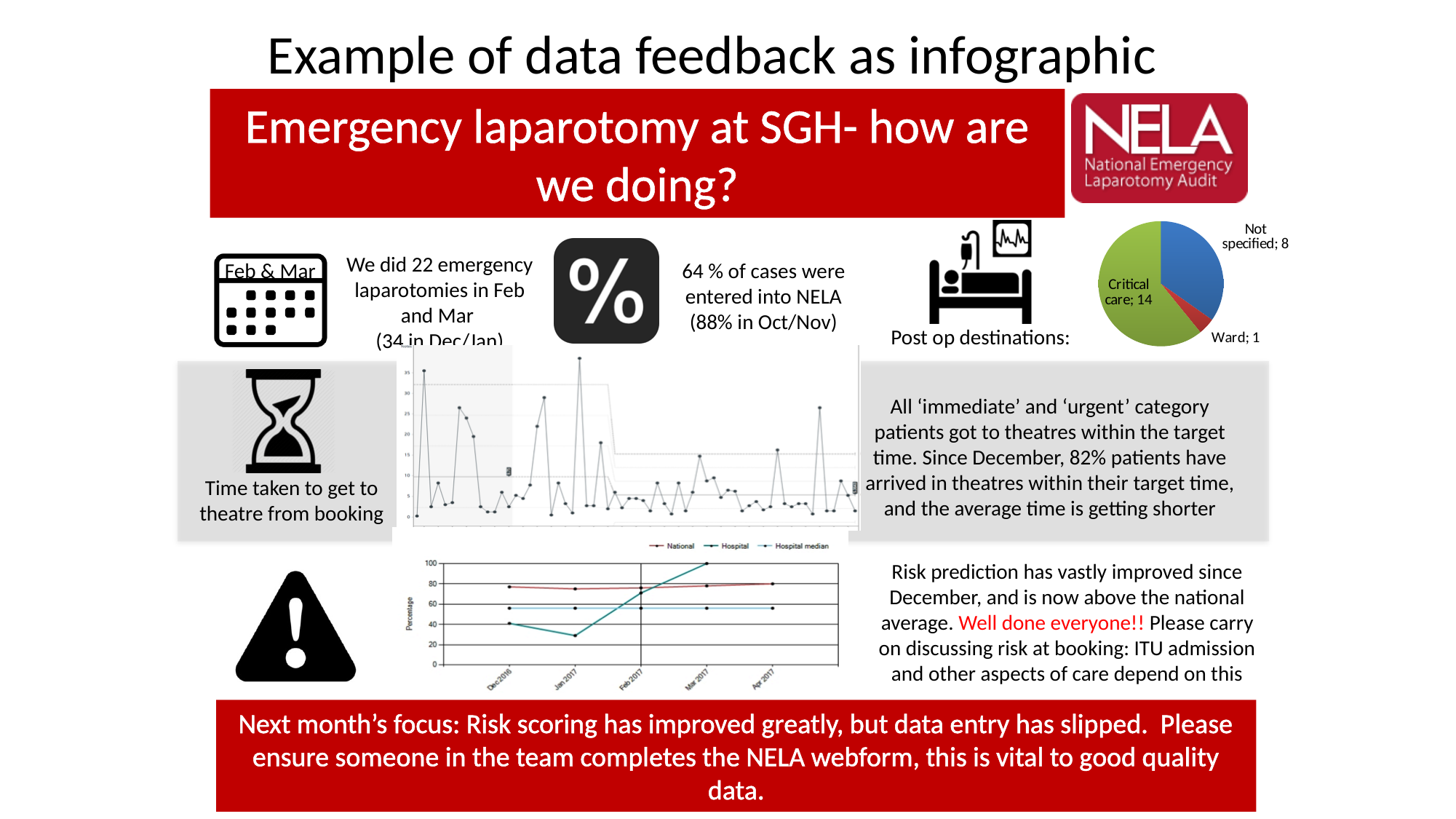
In the risk prediction line chart at the bottom of the slide, how many series does the legend list? 3 In the 'Post op destinations' pie chart, which destination has the smallest slice? Ward In the risk prediction line chart at the bottom of the slide, is the Hospital value for Jan 2017 greater or less than 40? less In the 'Post op destinations' pie chart, what is the value for Not specified? 8 In the 'Post op destinations' pie chart, what is the value for Ward? 1 In the risk prediction line chart at the bottom of the slide, how many months are shown on the x axis? 5 In the risk prediction line chart at the bottom of the slide, which is higher in Mar 2017, the Hospital value or the National value? Hospital In the 'Post op destinations' pie chart, what is the difference between the Critical care and Not specified values? 6 How many slices does the 'Post op destinations' pie chart have? 3 In the 'Post op destinations' pie chart, which destination has the largest slice? Critical care What kind of chart is the 'Post op destinations' chart? pie chart In the 'Post op destinations' pie chart, what is the value for Critical care? 14